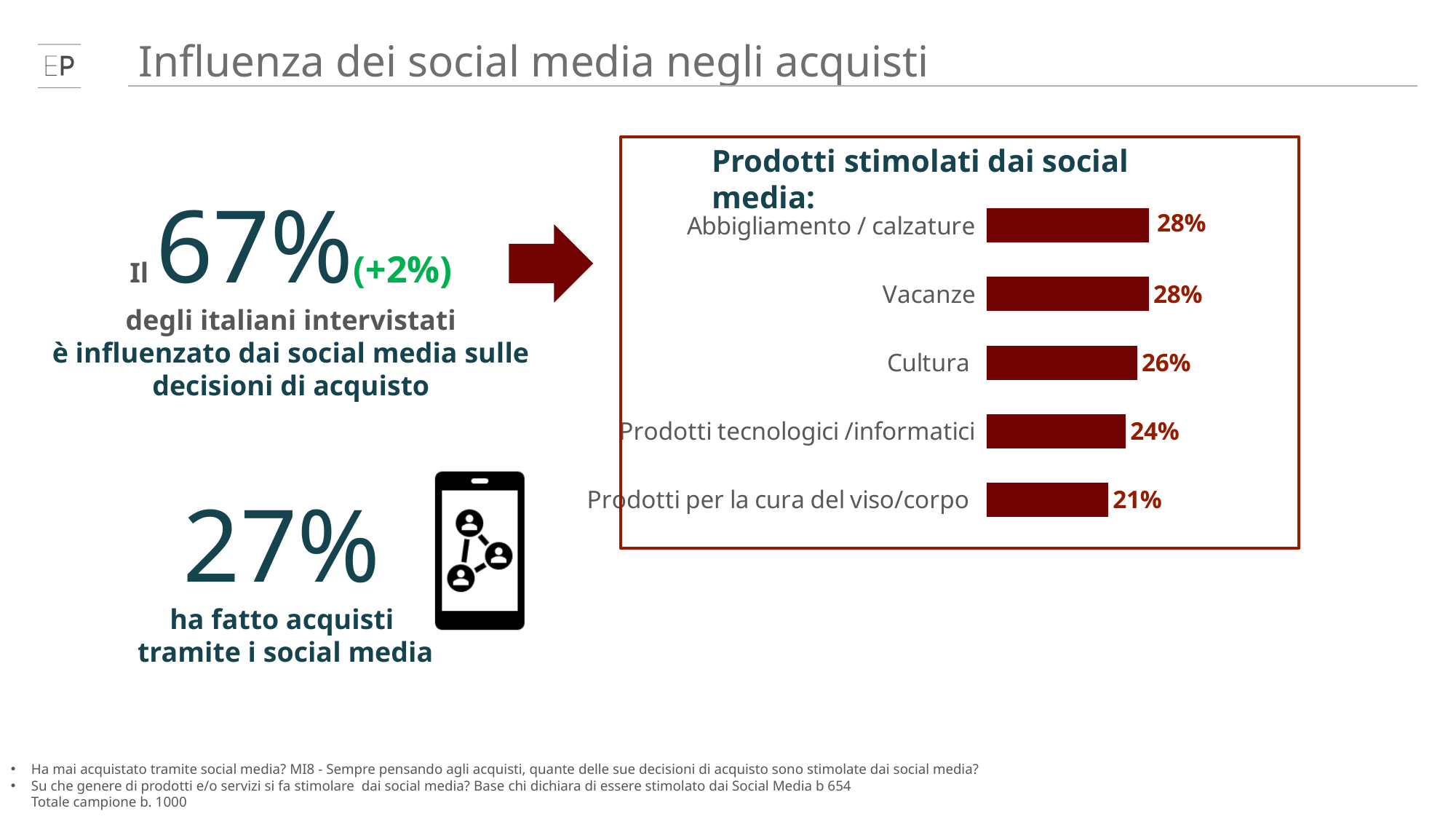
What is the value for Prodotti per la cura del viso/corpo? 21% Which is larger, the value for Cultura or the value for Prodotti tecnologici /informatici? Cultura What is the title of the chart? Prodotti stimolati dai social media: How many categories are shown in the chart? 5 Which category has the lowest value? Prodotti per la cura del viso/corpo What is the value for Prodotti tecnologici /informatici? 24% What is the difference between the values for Vacanze and Prodotti tecnologici /informatici? 4% What is the value for Cultura? 26% What kind of chart is shown? Bar chart What is the value for Abbigliamento / calzature? 28% What is the value for Vacanze? 28% What is the difference between the values for Cultura and Prodotti per la cura del viso/corpo? 5%